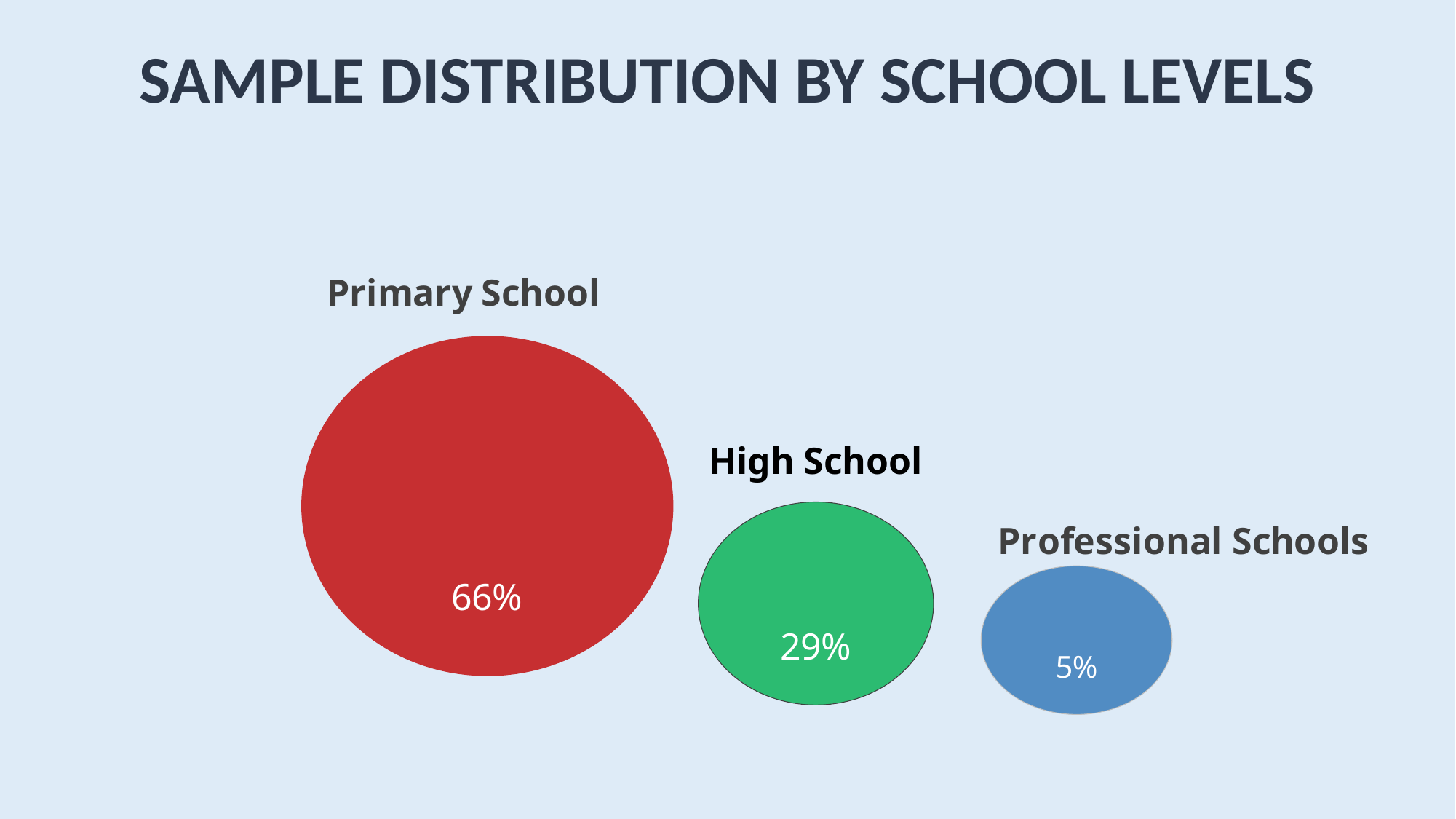
What is the title of the chart? Sample Distribution by School Levels Which is larger, the value for High School or the value for Professional Schools? High School What is the difference between the Primary School and High School values? 37% What is the value for High School? 29% What kind of chart is shown on the slide? Bubble chart What is the value for Primary School? 66% What is the difference between the High School and Professional Schools values? 24% What colour is the bubble for High School? Green What is the value for Professional Schools? 5% Which school level has the highest share of the sample? Primary School Which school level has the lowest share of the sample? Professional Schools How many school levels are shown on the chart? 3